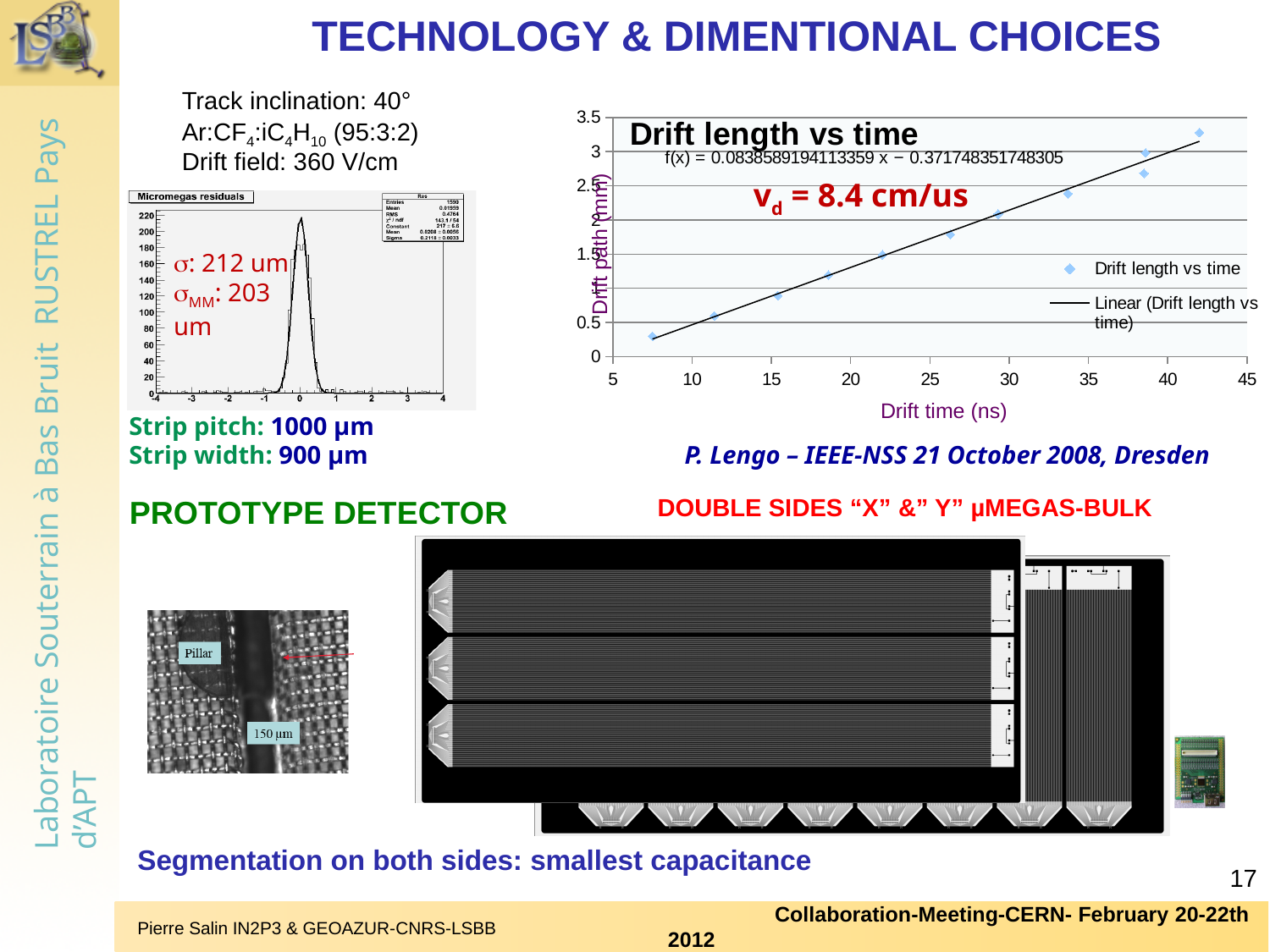
In the 'Drift length vs time' chart, do the drift path values rise or fall as drift time increases? rise What kind of chart is the 'Drift length vs time' chart? scatter chart In the 'Drift length vs time' chart, is the drift path value at a drift time of about 22 ns greater or less than 2? less What kind of chart is the 'Micromegas residuals' plot on the left of the slide? histogram In the 'Drift length vs time' chart, is the drift path at the largest drift time larger or smaller than the drift path at the smallest drift time? larger In the 'Drift length vs time' chart, is the drift path value at the largest drift time (around 42 ns) greater or less than 3? greater How many entries does the legend of the 'Drift length vs time' chart list? 2 What is the title of the chart on the right of the slide? Drift length vs time What drift velocity is annotated on the 'Drift length vs time' chart? v_d = 8.4 cm/us In the 'Drift length vs time' chart, which data point has the highest drift path: the one at the smallest drift time or the one at the largest drift time? the one at the largest drift time In the 'Drift length vs time' chart, is the drift path value at the smallest drift time (around 7 ns) greater or less than 0.5? less